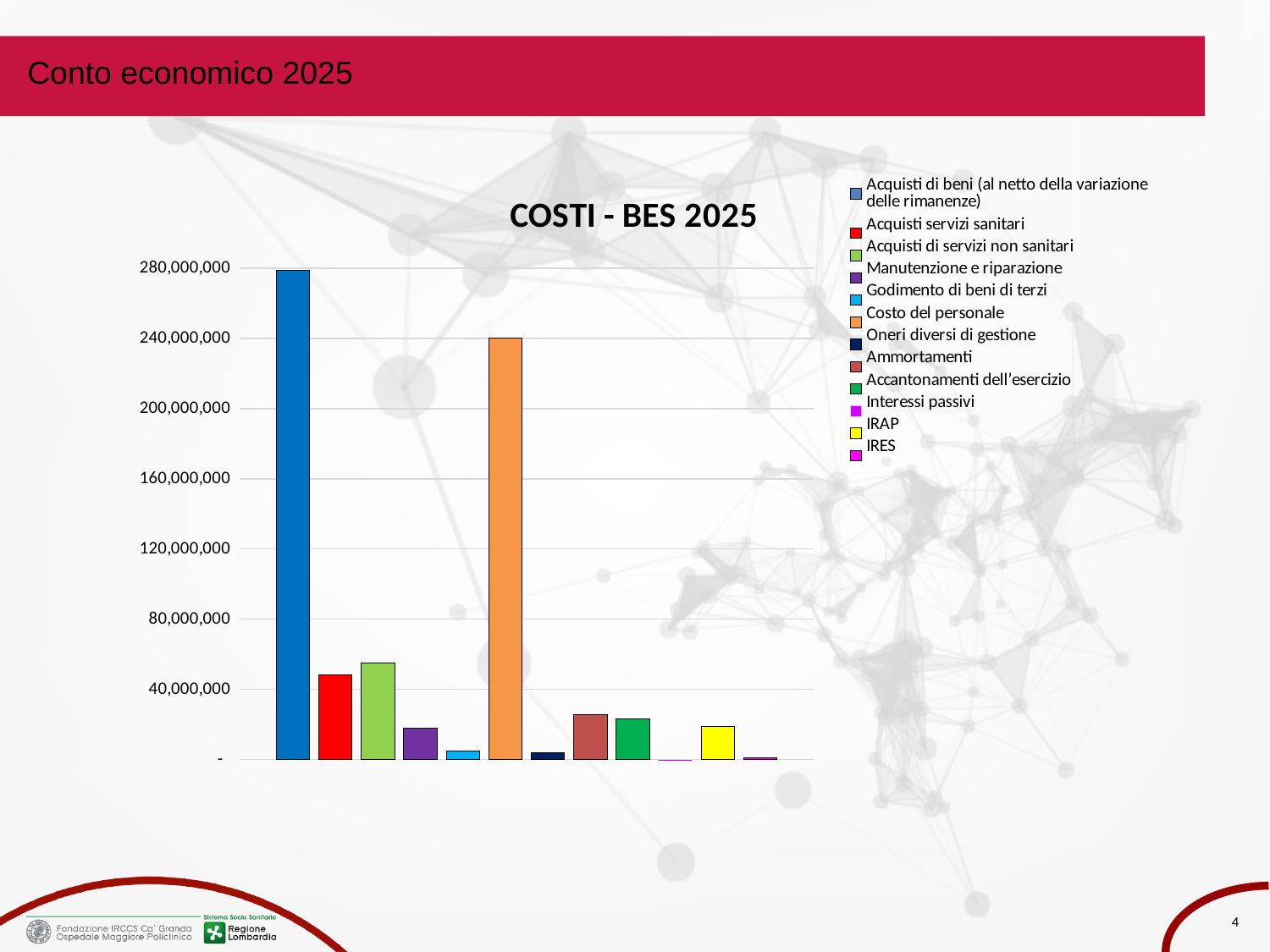
Is the value for Acquisti di beni (al netto della variazione delle rimanenze) greater or less than 240,000,000? greater Is the value for Acquisti servizi sanitari greater or less than 40,000,000? greater Which is larger, Acquisti di servizi non sanitari or Acquisti servizi sanitari? Acquisti di servizi non sanitari Which is larger, Acquisti di beni (al netto della variazione delle rimanenze) or Costo del personale? Acquisti di beni (al netto della variazione delle rimanenze) What kind of chart is shown on the slide? bar chart Is the value for Costo del personale greater or less than 200,000,000? greater What is the title of the chart? COSTI - BES 2025 Which cost item has the highest bar in the chart? Acquisti di beni (al netto della variazione delle rimanenze) How many series does the chart's legend list? 12 Which cost item has the lowest bar in the chart? Interessi passivi What colour is the bar for Costo del personale? orange